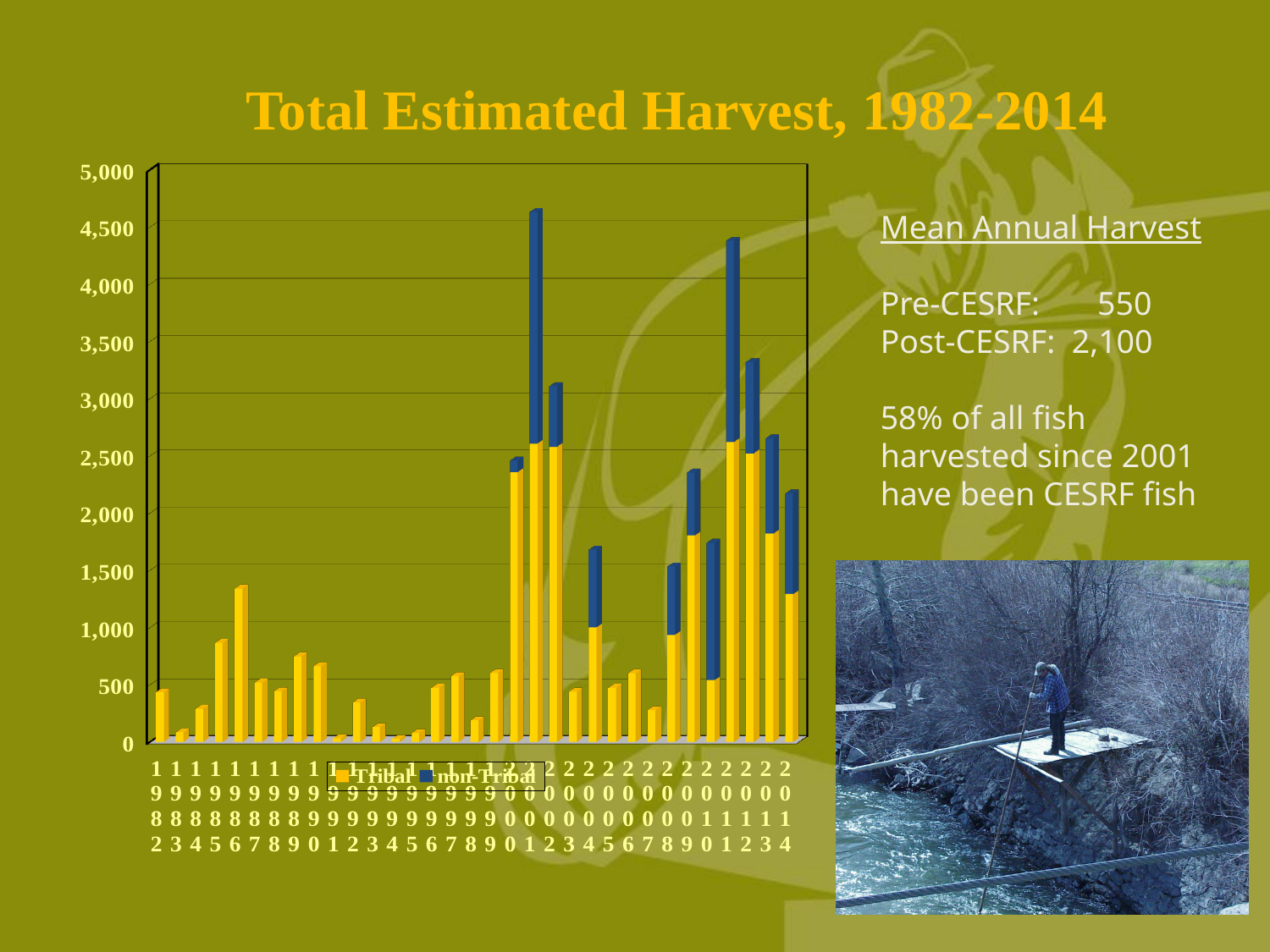
Is the total bar for 1991 greater or less than 500? less What kind of chart is shown on the slide? Stacked bar chart How many series does the chart legend list? 2 Which year has the tallest total bar? 2001 Is the total bar for 1986 greater or less than 1,000? greater Is the total bar for 2001 greater or less than 4,000? greater What is the title of the chart? Total Estimated Harvest, 1982-2014 Which year has the larger total bar, 1985 or 1986? 1986 What are the two series named in the chart legend? Tribal and non-Tribal How many years (categories) are plotted along the x axis? 33 Which year has the larger total bar, 2001 or 2011? 2001